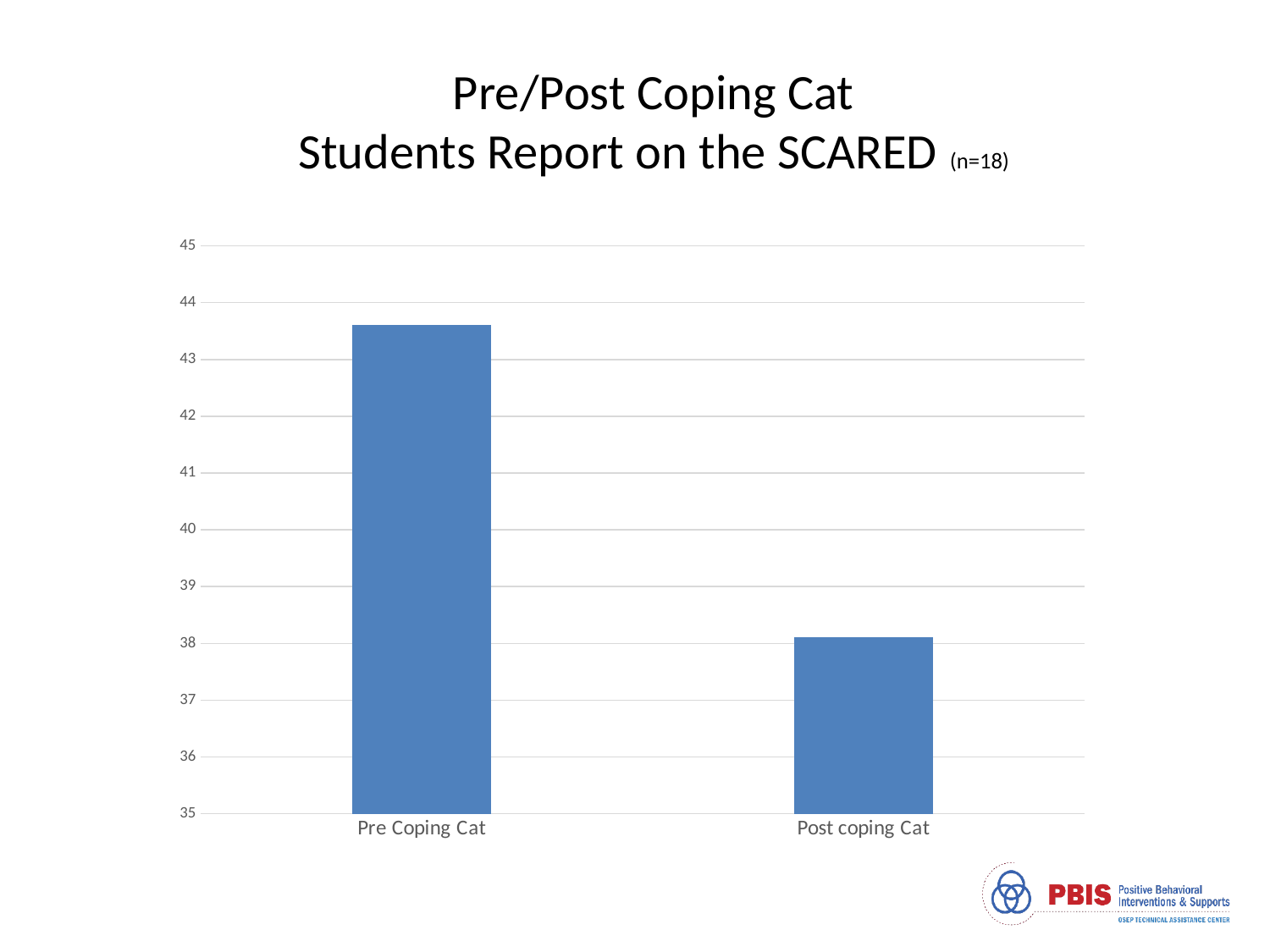
Do the values rise or fall from Pre Coping Cat to Post coping Cat? fall Is the value for Pre Coping Cat greater or less than 43? greater How many bars (categories) does the chart show? 2 Which is larger, the value for Pre Coping Cat or the value for Post coping Cat? Pre Coping Cat What is the lowest value shown on the vertical axis? 35 Which category has the highest value? Pre Coping Cat Is the value for Post coping Cat greater or less than 39? less What kind of chart is shown on the slide? bar chart Is the value for Pre Coping Cat greater or less than 44? less What is the sample size (n) given in the chart title? n=18 Which category has the lowest value? Post coping Cat